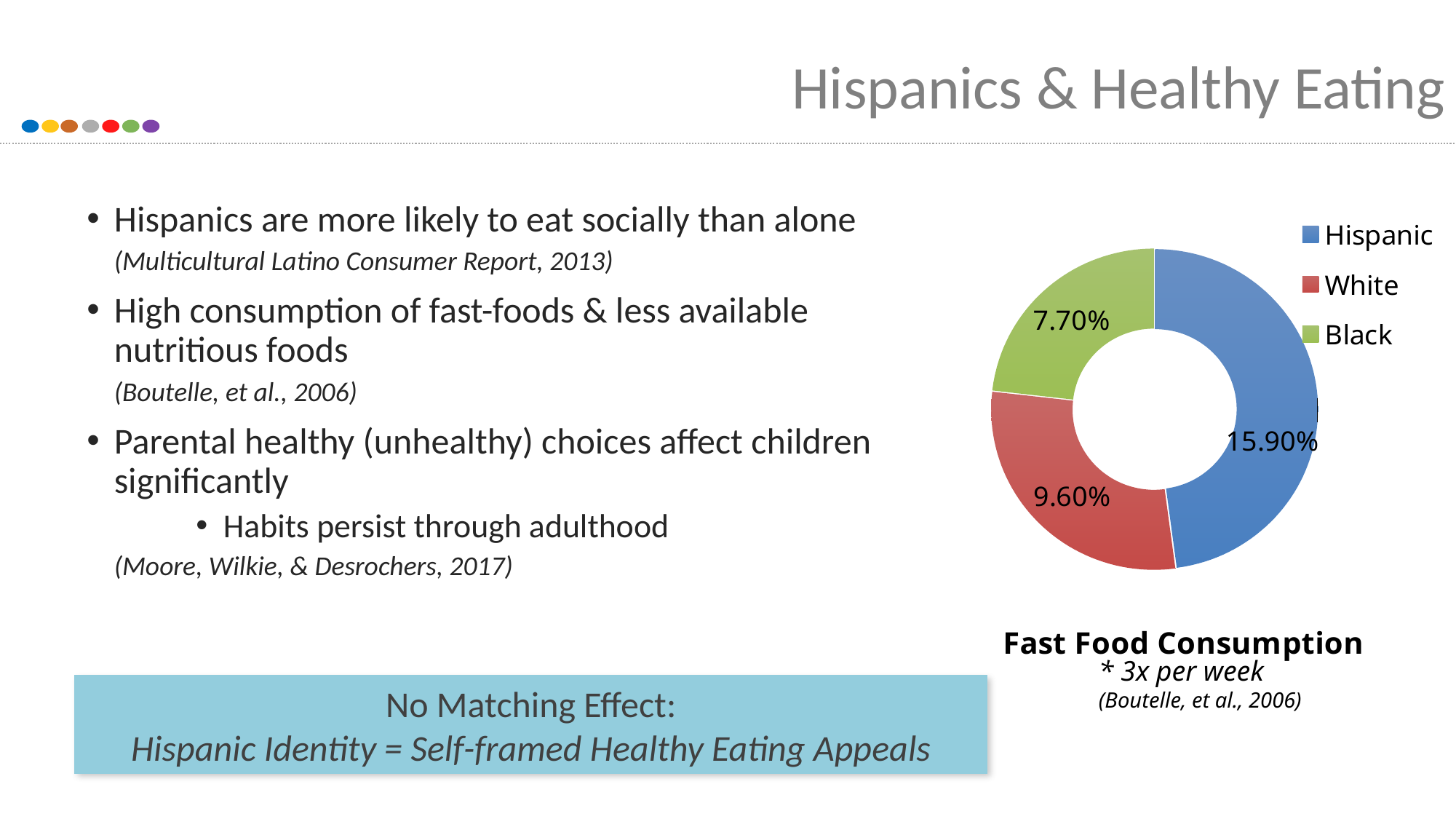
What kind of chart is the Fast Food Consumption chart? Doughnut chart Which group has the lowest value in the Fast Food Consumption chart? Black What value is shown for Black in the Fast Food Consumption chart? 7.70% What value is shown for White in the Fast Food Consumption chart? 9.60% Which group has the highest value in the Fast Food Consumption chart? Hispanic What is the title of the chart on the slide? Fast Food Consumption In the Fast Food Consumption chart, which is larger, the value for White or the value for Black? White What is the difference between the White and Black values in the Fast Food Consumption chart? 1.90% How many groups are shown in the Fast Food Consumption chart? 3 What value is shown for Hispanic in the Fast Food Consumption chart? 15.90% What is the difference between the Hispanic and White values in the Fast Food Consumption chart? 6.30% What colour represents Black in the Fast Food Consumption chart? Green